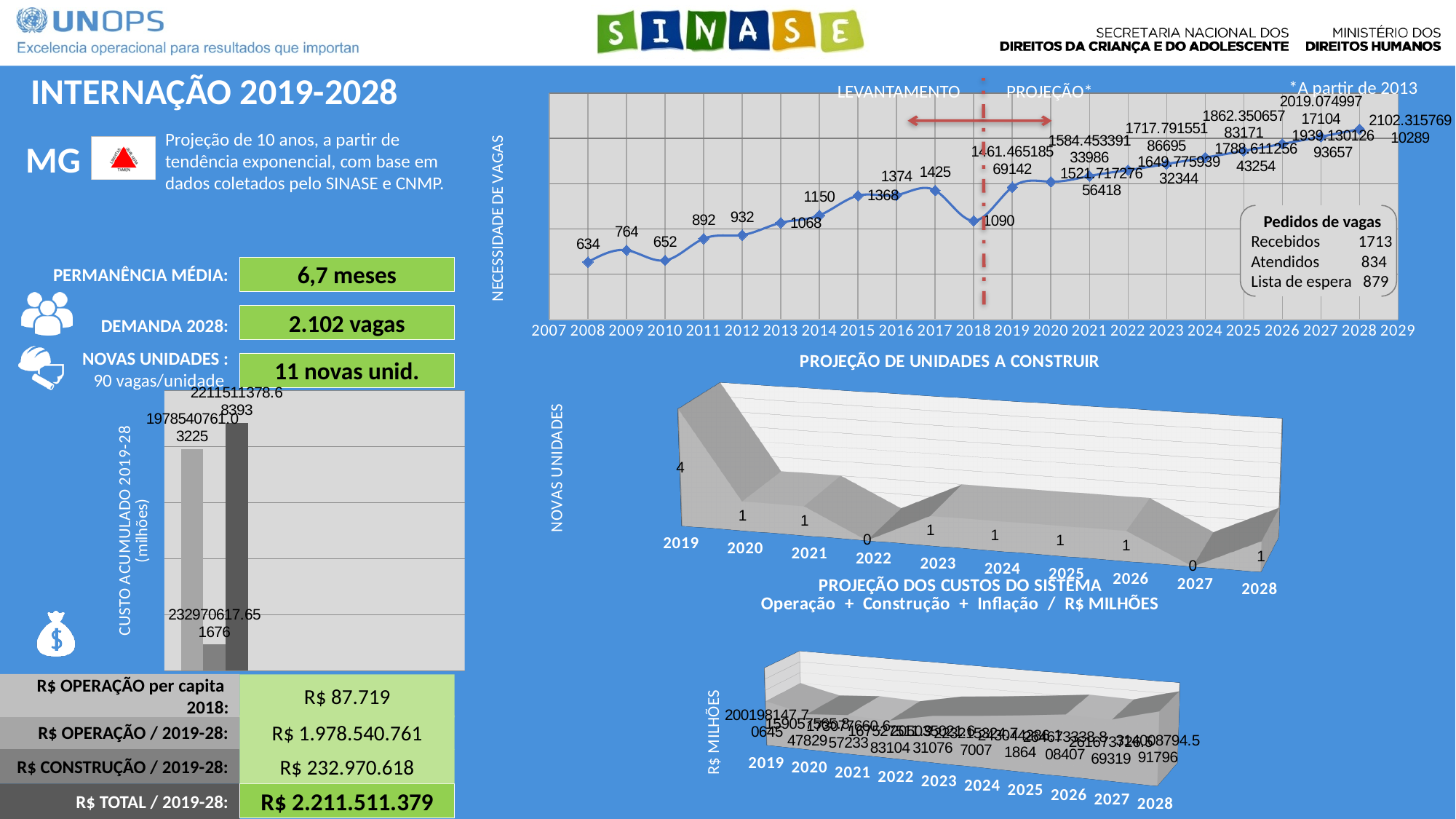
In the PROJEÇÃO DE UNIDADES A CONSTRUIR chart, which year has the highest value? 2019 In the PROJEÇÃO DE UNIDADES A CONSTRUIR chart, how many years are shown on the x axis? 10 In the NECESSIDADE DE VAGAS line chart, what is the value for 2017? 1425 In the PROJEÇÃO DE UNIDADES A CONSTRUIR chart, what is the difference between the values for 2019 and 2020? 3 In the NECESSIDADE DE VAGAS line chart, which is larger, the value for 2017 or the value for 2018? 2017 In the NECESSIDADE DE VAGAS line chart, what is the value for 2008? 634 In the PROJEÇÃO DE UNIDADES A CONSTRUIR chart, what is the value for 2027? 0 In the PROJEÇÃO DE UNIDADES A CONSTRUIR chart, what is the value for 2019? 4 In the NECESSIDADE DE VAGAS line chart, what kind of chart is used? line chart In the NECESSIDADE DE VAGAS line chart, what is the value for 2018? 1090 In the NECESSIDADE DE VAGAS line chart, what does the dotted vertical line separate? LEVANTAMENTO and PROJEÇÃO In the NECESSIDADE DE VAGAS line chart, what is the difference between the values for 2009 and 2010? 112